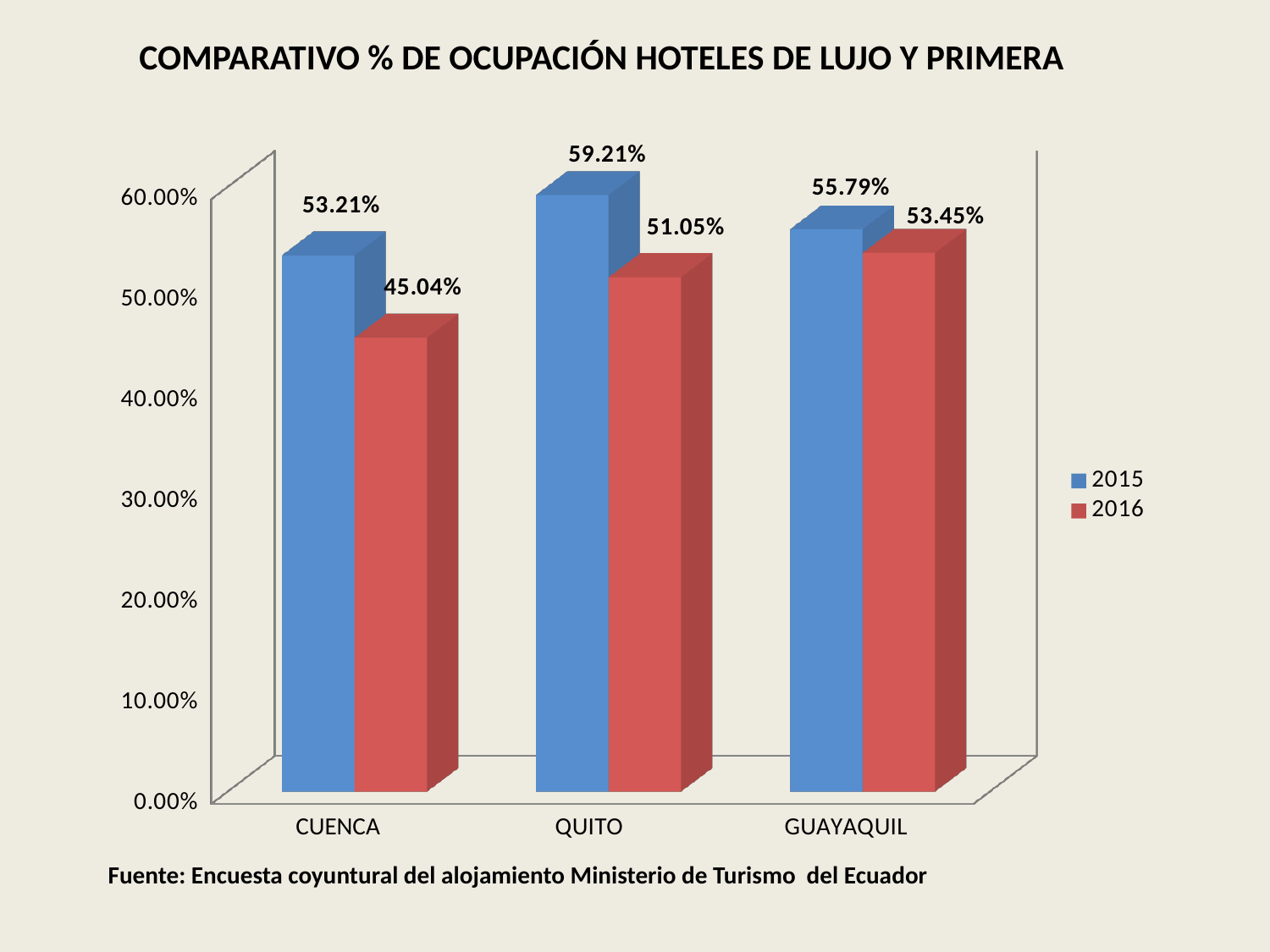
What is the 2016 occupancy value for QUITO? 51.05% Is the 2016 value for CUENCA greater or less than 50.00%? less What is the title of the chart? COMPARATIVO % DE OCUPACIÓN HOTELES DE LUJO Y PRIMERA What kind of chart is shown on the slide? bar chart What is the 2015 occupancy value for CUENCA? 53.21% How many cities are shown on the x axis? 3 Which city has the highest 2015 occupancy value? QUITO Which is larger for GUAYAQUIL, the 2015 value or the 2016 value? 2015 What is the difference between the 2015 and 2016 values for CUENCA? 8.17% What is the 2016 occupancy value for GUAYAQUIL? 53.45% How many series does the legend list? 2 Which city has the lowest 2016 occupancy value? CUENCA